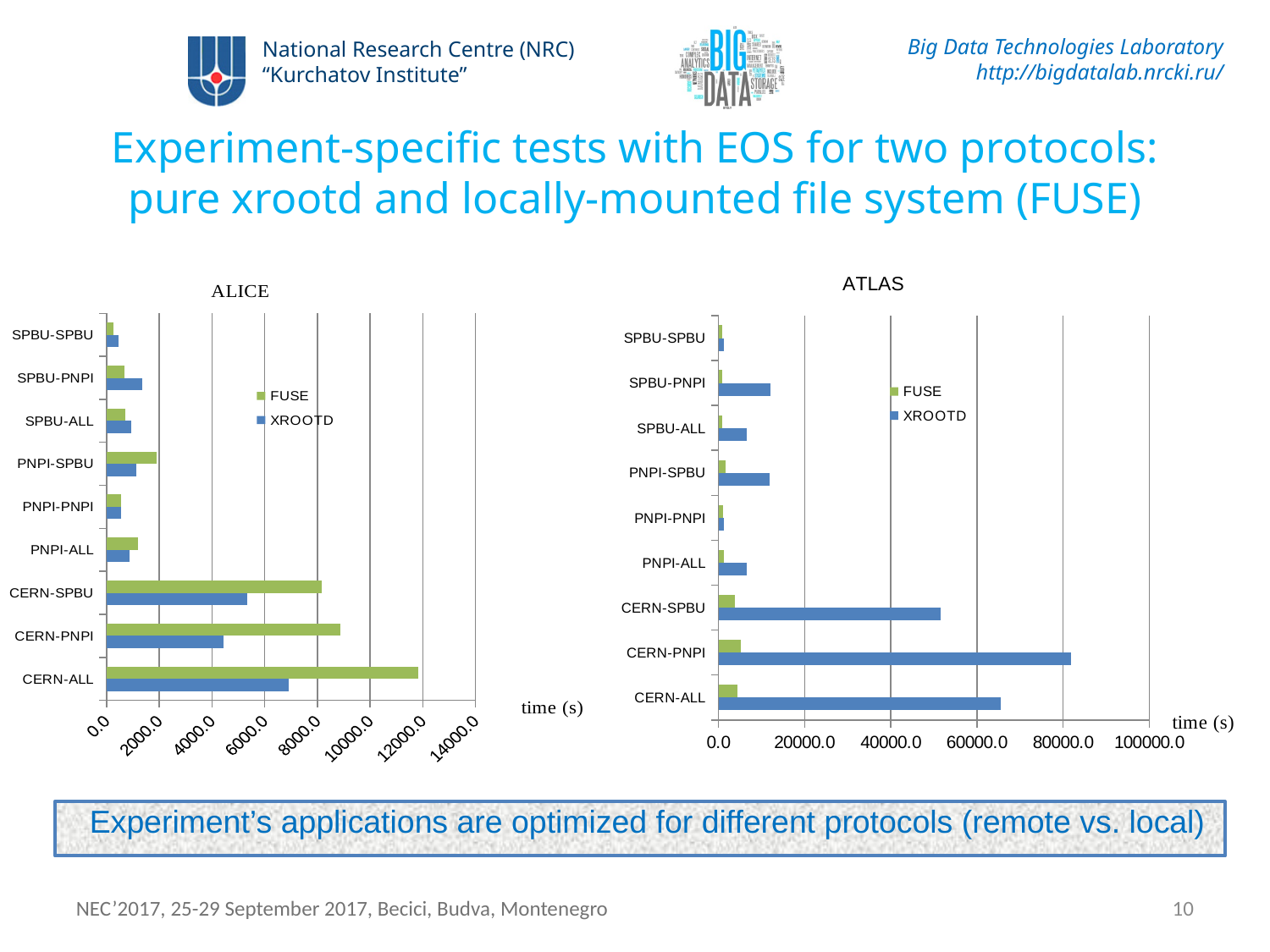
In the ALICE chart, for CERN-ALL, which series has the larger value, FUSE or XROOTD? FUSE In the ALICE chart, is the FUSE value for CERN-ALL greater or less than 10000.0? greater In the ALICE chart, is the XROOTD value for CERN-PNPI greater or less than 6000.0? less How many series does the legend of the ATLAS chart list? 2 In the ALICE chart, which category has the highest FUSE value? CERN-ALL In the ATLAS chart, for CERN-PNPI, which series has the larger value, FUSE or XROOTD? XROOTD In the ATLAS chart, is the XROOTD value for CERN-ALL greater or less than 80000.0? less In the ATLAS chart, which category has the highest XROOTD value? CERN-PNPI What unit is shown on the x axis of the ATLAS chart? time (s) What kind of chart is the ALICE chart? bar chart How many categories are shown on the ALICE chart? 9